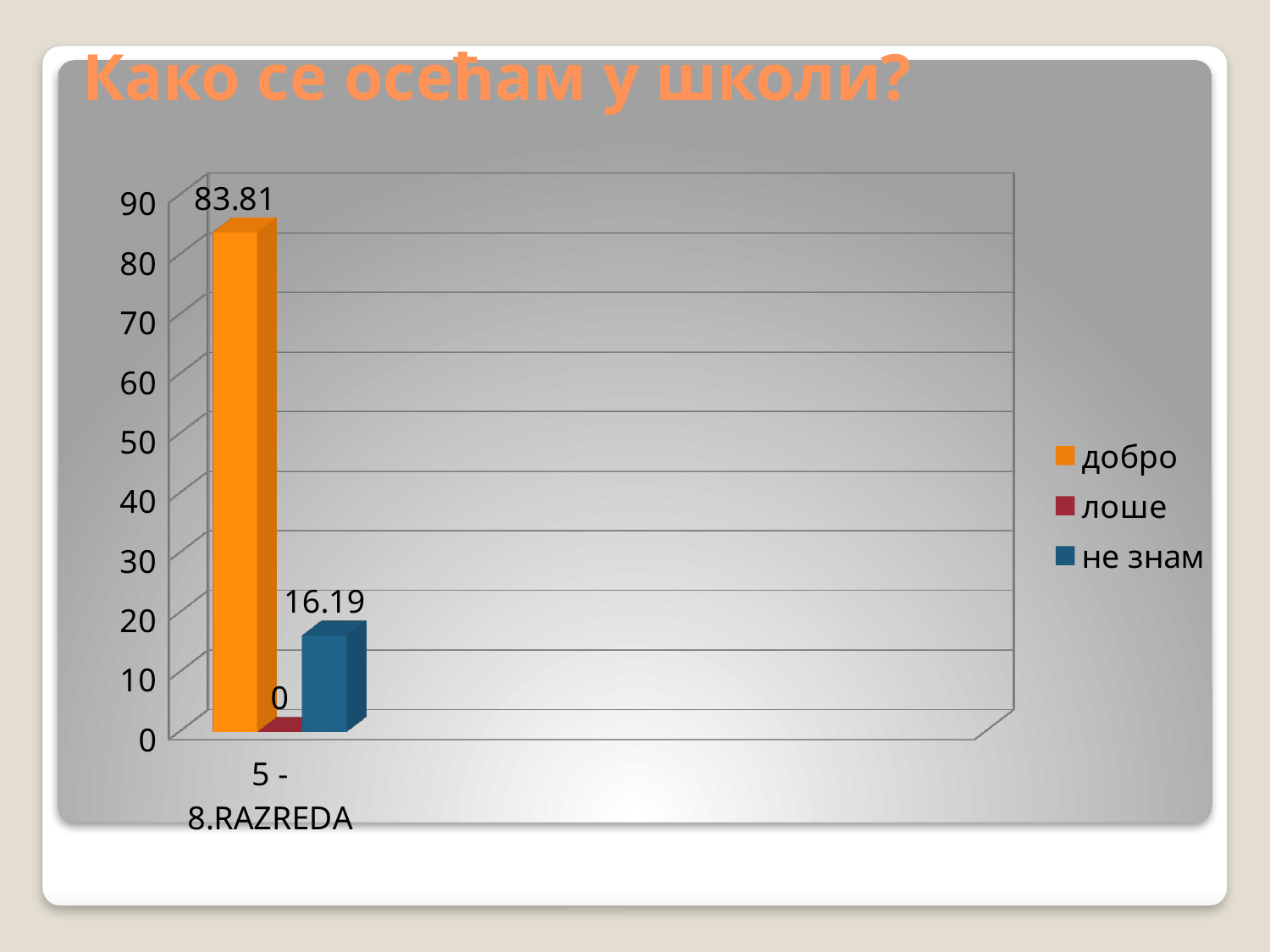
How many series does the legend list? 3 How many categories are shown on the x axis? 1 Which series has the highest value? добро What is the value for "лоше" for the category "5 - 8.RAZREDA"? 0 What is the value for "добро" for the category "5 - 8.RAZREDA"? 83.81 Which is larger, the value for "добро" or the value for "не знам"? добро Is the value for "не знам" greater or less than 20? less What kind of chart is shown on the slide? bar chart Which series has the lowest value? лоше What is the difference between the values for "добро" and "не знам"? 67.62 What is the title of the slide? Како се осећам у школи? What is the value for "не знам" for the category "5 - 8.RAZREDA"? 16.19